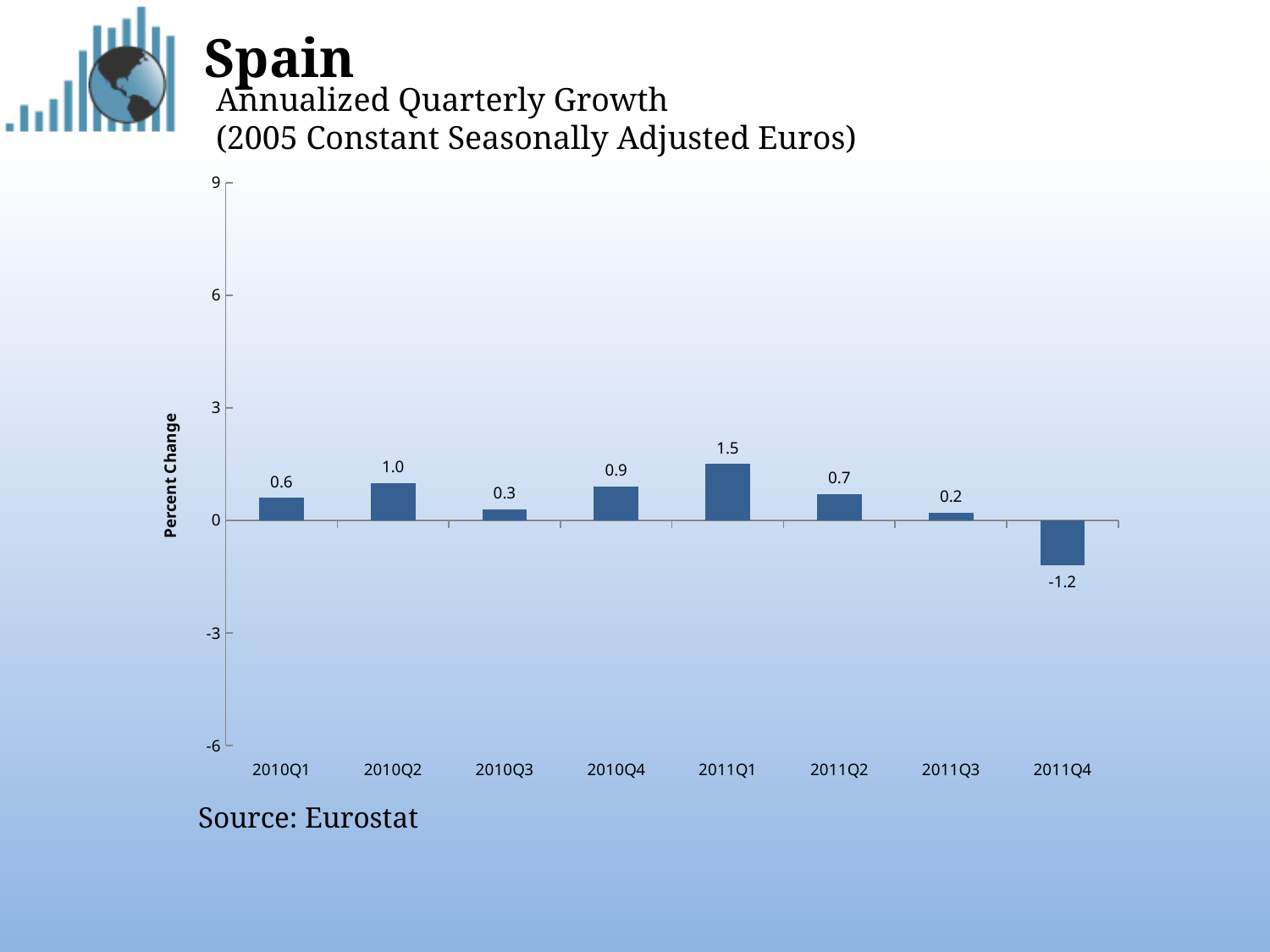
Which quarter has the highest value? 2011Q1 What is the label on the y axis? Percent Change Which is larger, the value for 2010Q4 or the value for 2010Q3? 2010Q4 Is the value for 2011Q1 greater or less than 3? less How many quarters are shown on the x axis? 8 Does the value rise or fall from 2011Q1 to 2011Q4? fall What kind of chart is shown on the slide? bar chart What is the annualized quarterly growth value for 2011Q1? 1.5 What is the difference between the values for 2011Q1 and 2011Q2? 0.8 What is the value shown for 2011Q4? -1.2 What is the value shown for 2010Q2? 1.0 Which quarter has the lowest value? 2011Q4